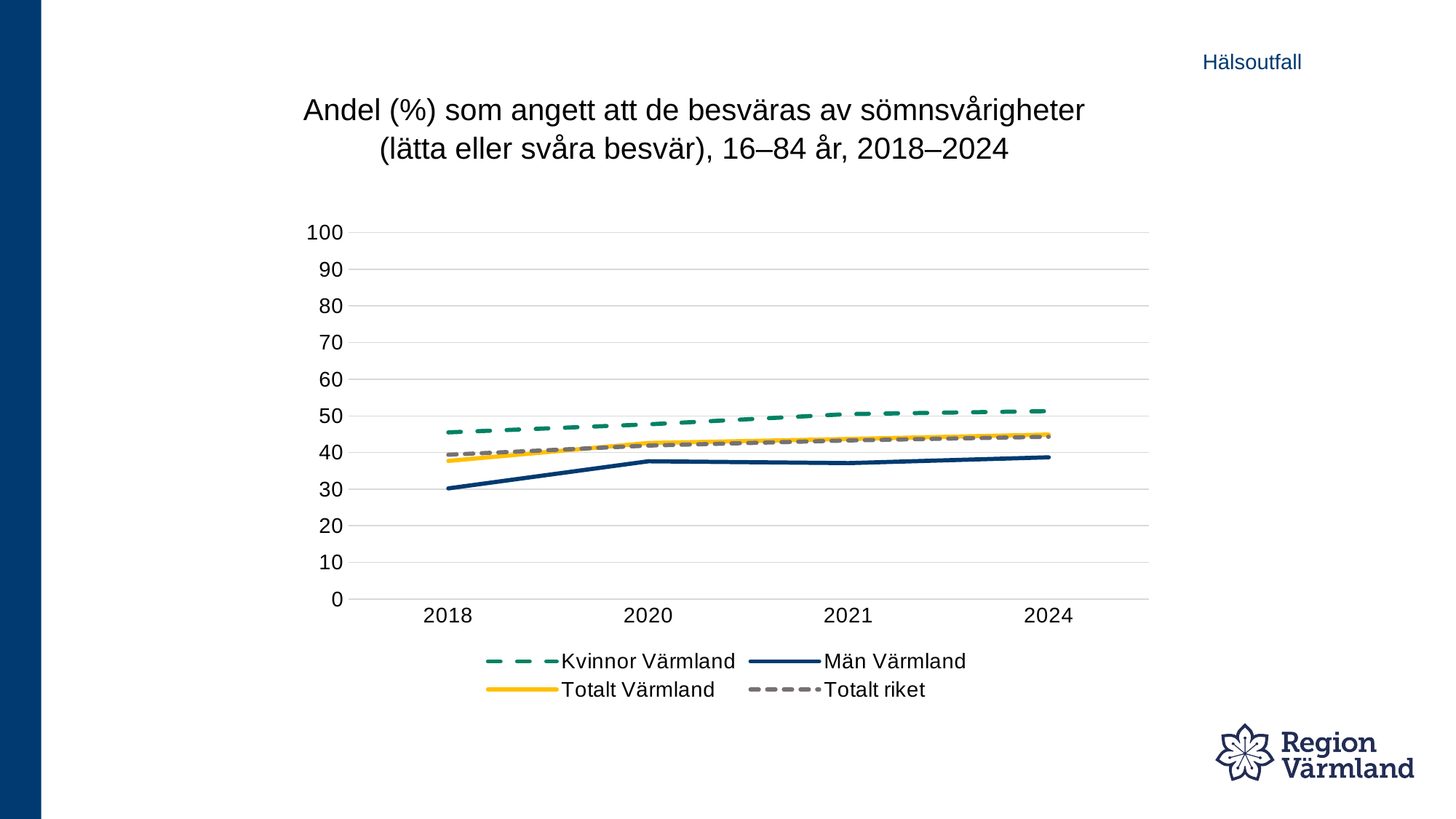
Is the value for Totalt Värmland in 2024 greater or less than 50? less What kind of chart is shown on the slide? line chart Which series has the lowest value in 2018? Män Värmland Is the value for Män Värmland in 2018 greater or less than 40? less Which is larger in 2018, the value for Kvinnor Värmland or the value for Män Värmland? Kvinnor Värmland Which series has the highest value in 2024? Kvinnor Värmland Does the Kvinnor Värmland line rise or fall from 2018 to 2024? rise Which series is drawn as a solid yellow line? Totalt Värmland What is the first year shown on the x axis? 2018 How many series does the legend list? 4 How many years are shown on the x axis? 4 Is the value for Kvinnor Värmland in 2018 greater or less than 40? greater